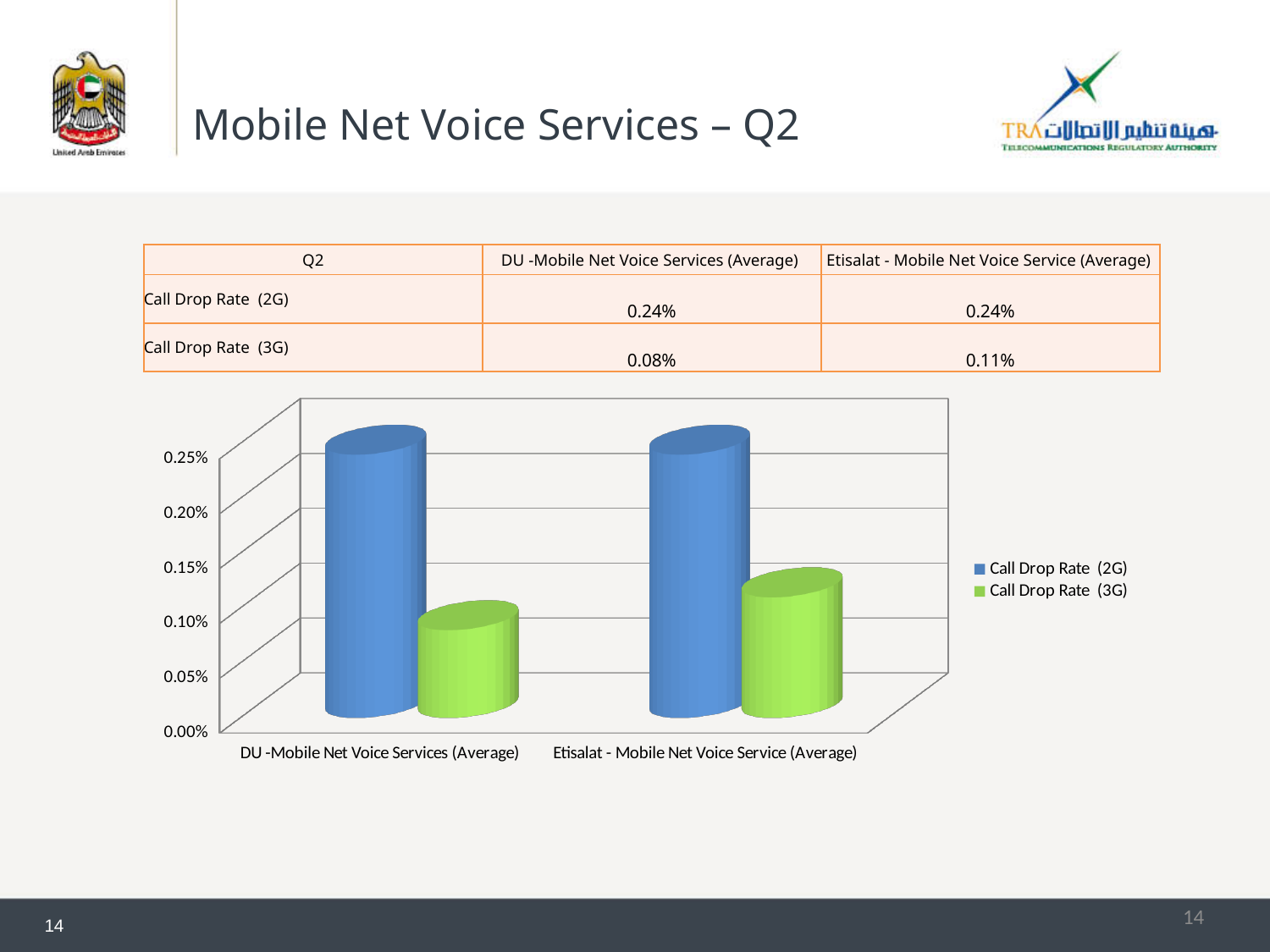
What kind of chart is shown on the slide? bar chart How many categories are shown along the x axis of the chart? 2 Is the Call Drop Rate (3G) for DU greater or less than 0.10%? less What is the difference between the Call Drop Rate (3G) for Etisalat and for DU? 0.03% Which colour represents Call Drop Rate (3G) in the chart legend? green For DU, what is the difference between the Call Drop Rate (2G) and the Call Drop Rate (3G)? 0.16% Is the Call Drop Rate (2G) for DU greater or less than 0.20%? greater How many series does the chart legend list? 2 Which has the higher Call Drop Rate (3G), DU or Etisalat? Etisalat What is the Call Drop Rate (2G) for DU - Mobile Net Voice Services (Average)? 0.24% What is the Call Drop Rate (3G) for DU - Mobile Net Voice Services (Average)? 0.08% What is the Call Drop Rate (3G) for Etisalat - Mobile Net Voice Service (Average)? 0.11%